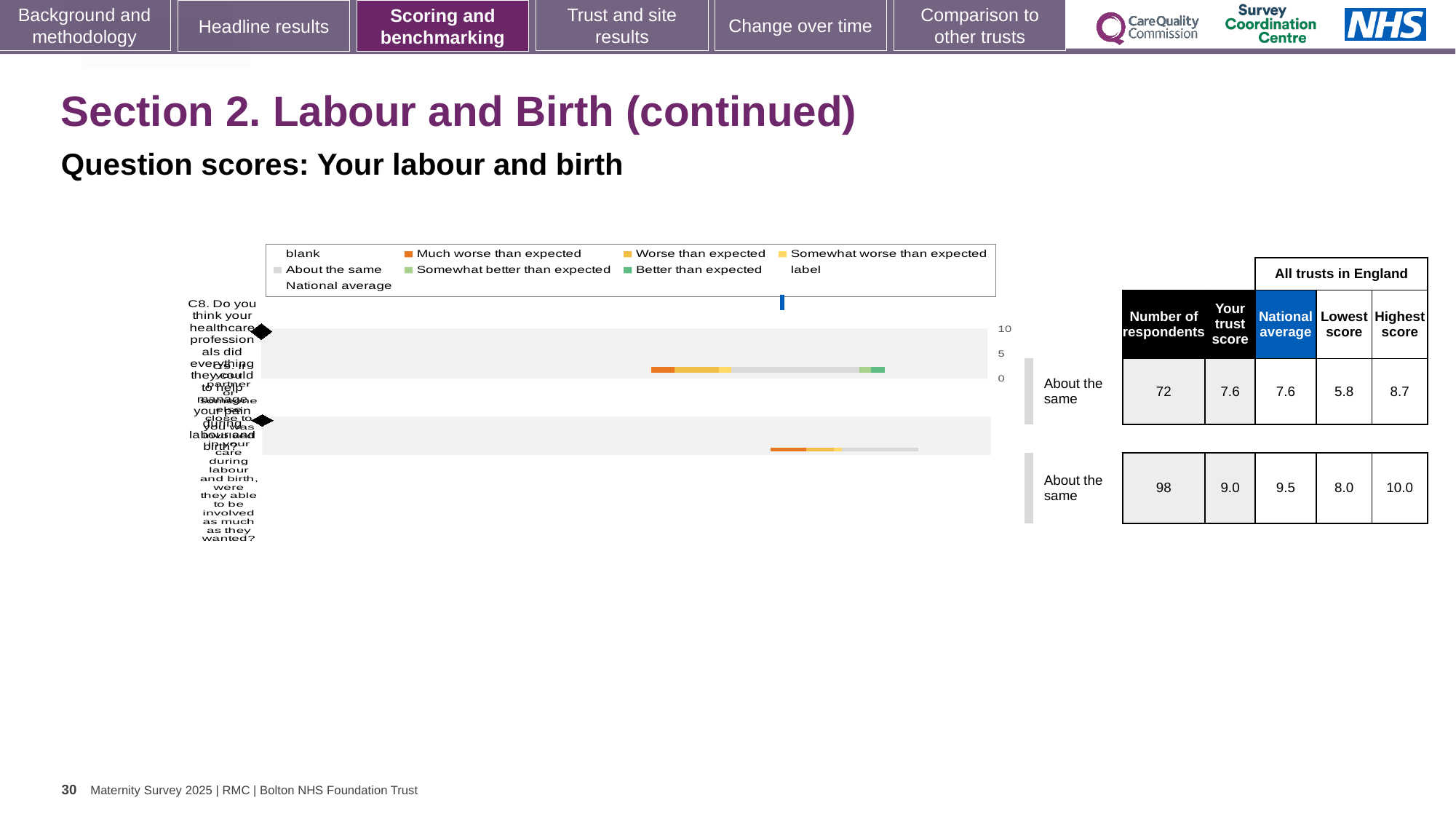
How many question rows (bars) are plotted in the chart? 2 What is the national average for the first (top) question row? 7.6 What is the highest score across all trusts in England for the second (bottom) question row? 10.0 What benchmark category is shown next to both question rows? About the same For the second (bottom) question row, how much higher is the national average than the trust score? 0.5 What colour does the legend use for 'Much worse than expected'? Orange For the second (bottom) question row, which is larger: the trust score or the national average? National average What is the number of respondents for the first (top) question row? 72 What kind of chart is shown on the slide? bar chart What is the trust score for the second (bottom) question row? 9.0 What is the difference between the highest score and the lowest score for the first (top) question row? 2.9 What is the lowest score across all trusts in England for the second (bottom) question row? 8.0